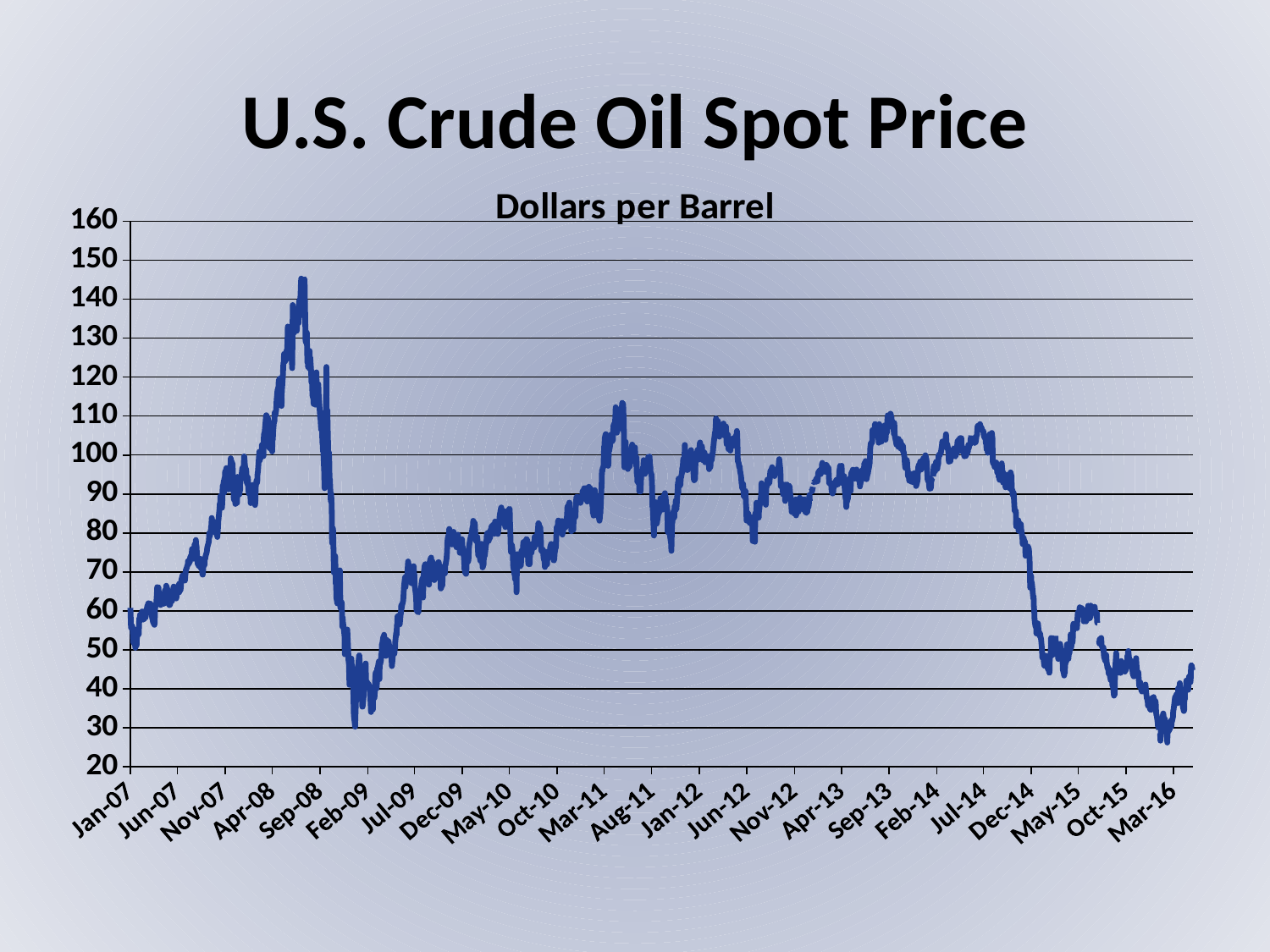
In which year does the price reach its highest peak? 2008 Is the value at Jan-07 greater or less than 70? less What kind of chart is shown on the slide? line chart Is the value at Jul-14 greater or less than 90? greater What unit is the price measured in, according to the chart subtitle? Dollars per Barrel Is the value at Feb-09 greater or less than 60? less How many date labels are shown along the x axis? 23 Does the price rise or fall between Jul-14 and Dec-14? fall What is the title of the chart? U.S. Crude Oil Spot Price